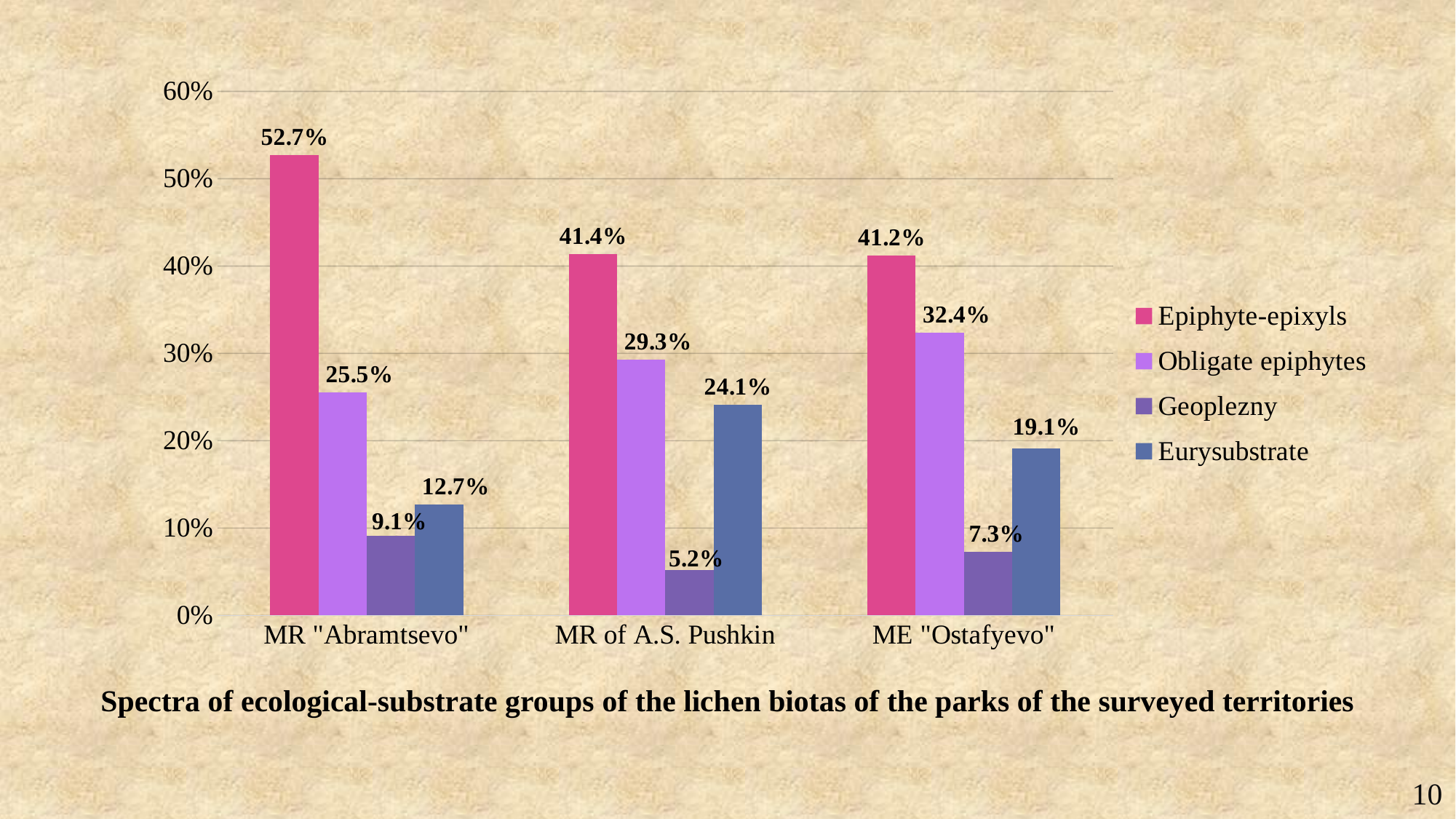
How many series does the legend list? 4 What kind of chart is shown on the slide? Bar chart What is the value for Epiphyte-epixyls at MR "Abramtsevo"? 52.7% Which park has the highest value for Epiphyte-epixyls? MR "Abramtsevo" What is the value for Obligate epiphytes at MR of A.S. Pushkin? 29.3% What is the value for Eurysubstrate at ME "Ostafyevo"? 19.1% What is the difference between the Obligate epiphytes values at ME "Ostafyevo" and MR "Abramtsevo"? 6.9% How many parks (categories) are shown on the x axis? 3 Is the value for Obligate epiphytes at ME "Ostafyevo" greater or less than 30%? greater Which park has the lowest value for Geoplezny? MR of A.S. Pushkin What is the value for Geoplezny at MR of A.S. Pushkin? 5.2% Which is larger: Eurysubstrate at MR of A.S. Pushkin or Eurysubstrate at MR "Abramtsevo"? MR of A.S. Pushkin